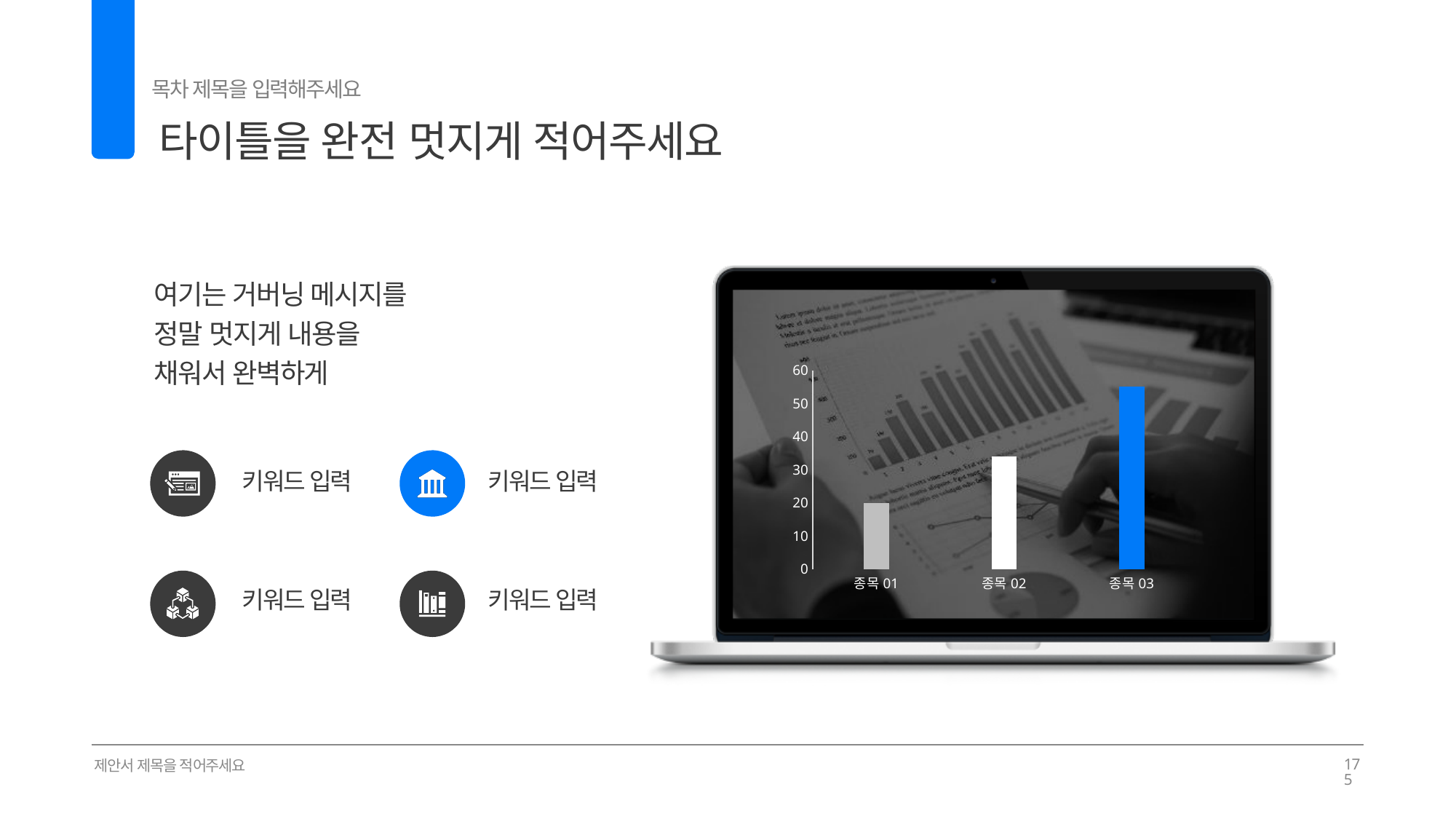
What is the highest value shown on the chart's vertical axis? 60 How many categories does the bar chart show? 3 Is the value for 종목 01 greater or less than 30? less Do the bar values rise or fall from 종목 01 to 종목 03? rise Is the value for 종목 02 greater or less than 40? less Which category has the highest bar in the chart? 종목 03 Is the value for 종목 03 greater or less than 50? greater Which category has the lowest bar in the chart? 종목 01 What colour is the bar for 종목 03? blue Which is larger, the bar for 종목 02 or the bar for 종목 03? 종목 03 What kind of chart is shown on the laptop screen? bar chart